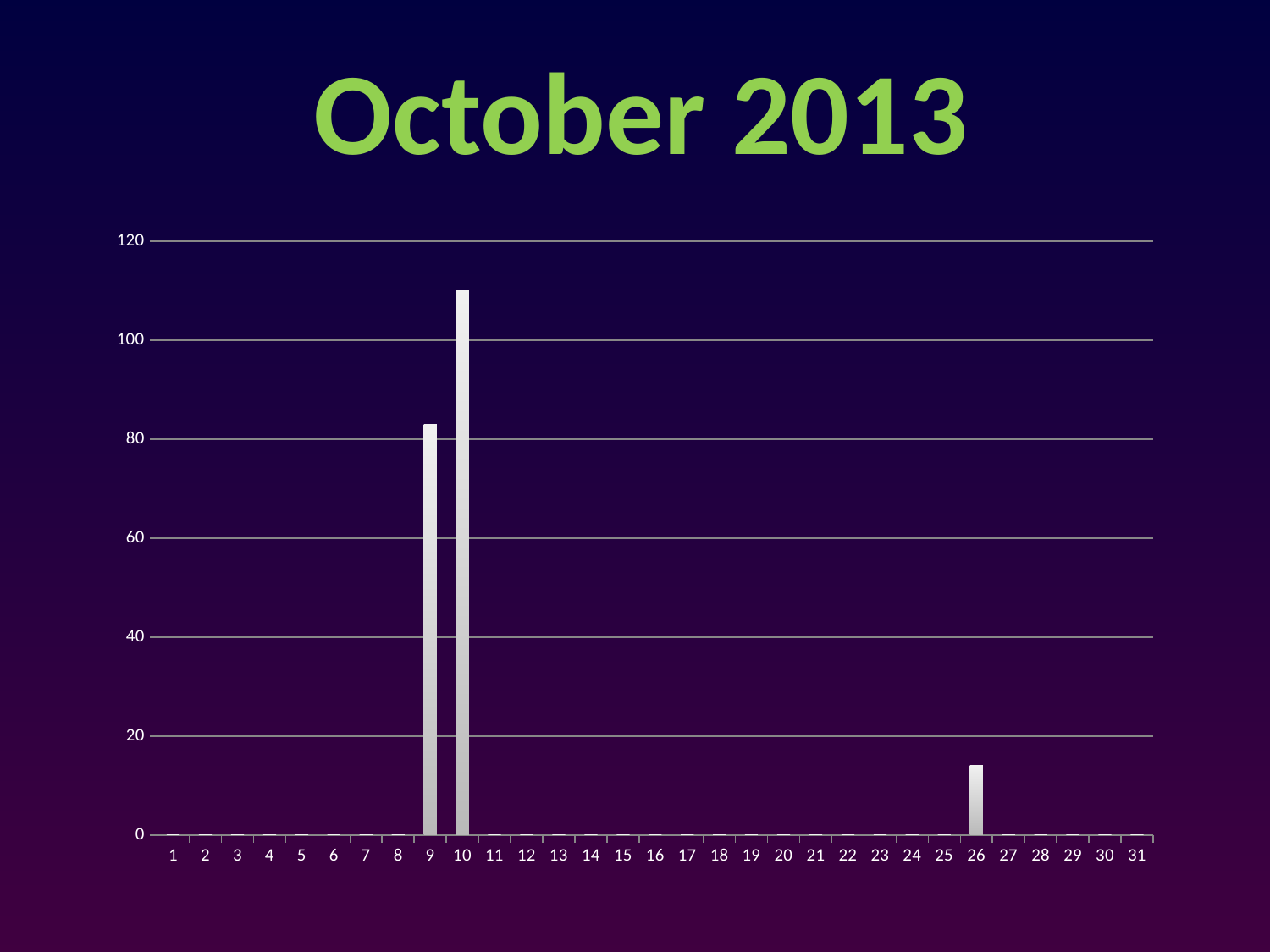
How many categories are shown along the x axis? 31 What is the title of the chart? October 2013 Which day has the highest value? 10 Is the value for day 26 greater or less than 20? less What is the highest value shown on the y axis? 120 Is the value for day 9 greater or less than 100? less What kind of chart is shown on the slide? bar chart How many days have a visible non-zero bar? 3 Which is larger, the value for day 9 or the value for day 10? day 10 Which is larger, the value for day 9 or the value for day 26? day 9 Is the value for day 10 greater or less than 100? greater